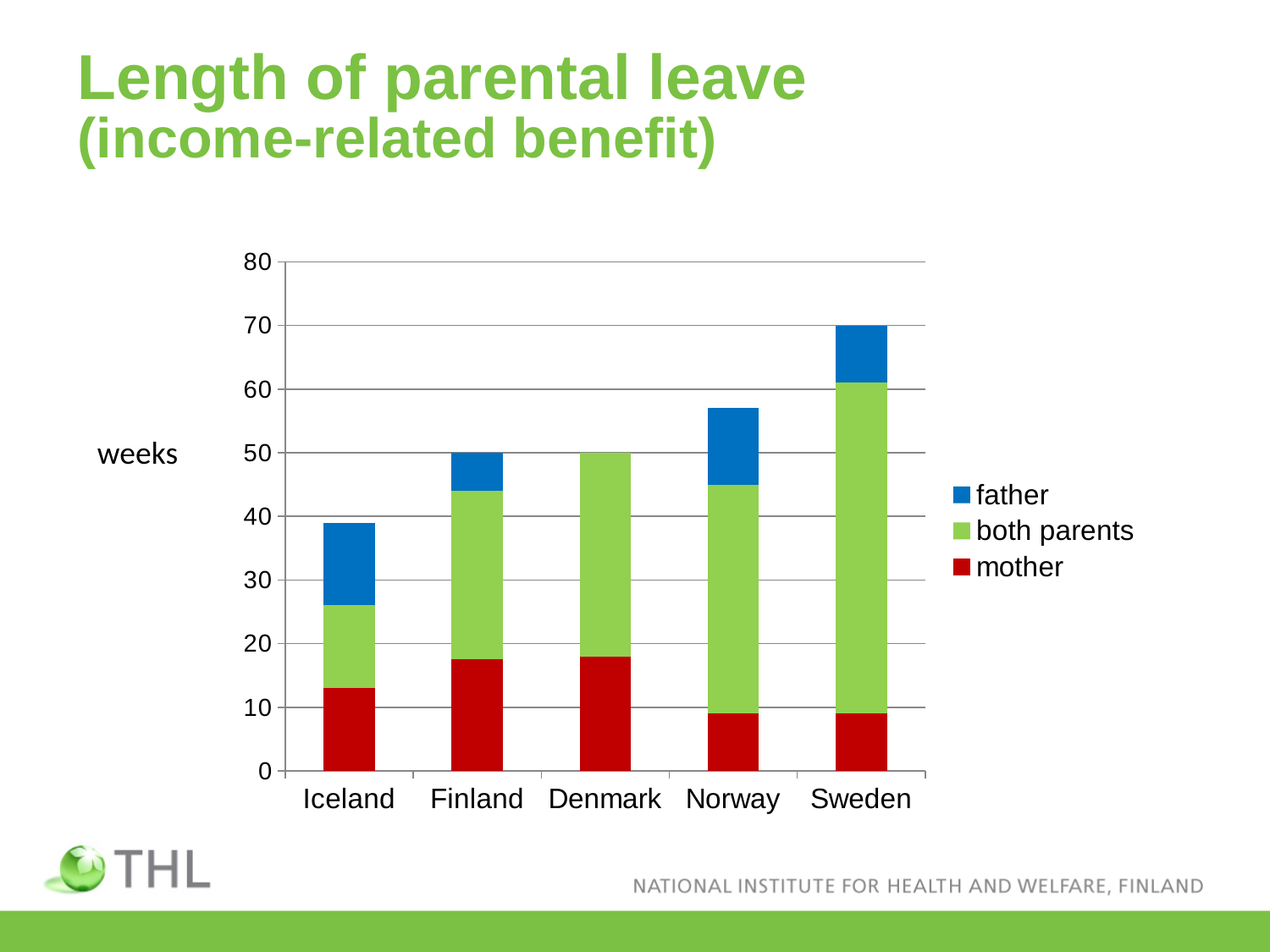
What kind of chart is shown on the slide? bar chart Which country has the lowest total length of parental leave? Iceland Is the total value for Iceland greater or less than 50? less How many series does the legend list? 3 What is the total length of parental leave for Sweden in weeks? 70 Which is larger, the father segment for Iceland or the father segment for Finland? Iceland How many countries are shown on the x axis? 5 Which country has the highest total length of parental leave? Sweden Is the total value for Norway greater or less than 50? greater What is the total length of parental leave for Finland in weeks? 50 What unit is shown on the y axis label? weeks Which country has no father segment in its bar? Denmark